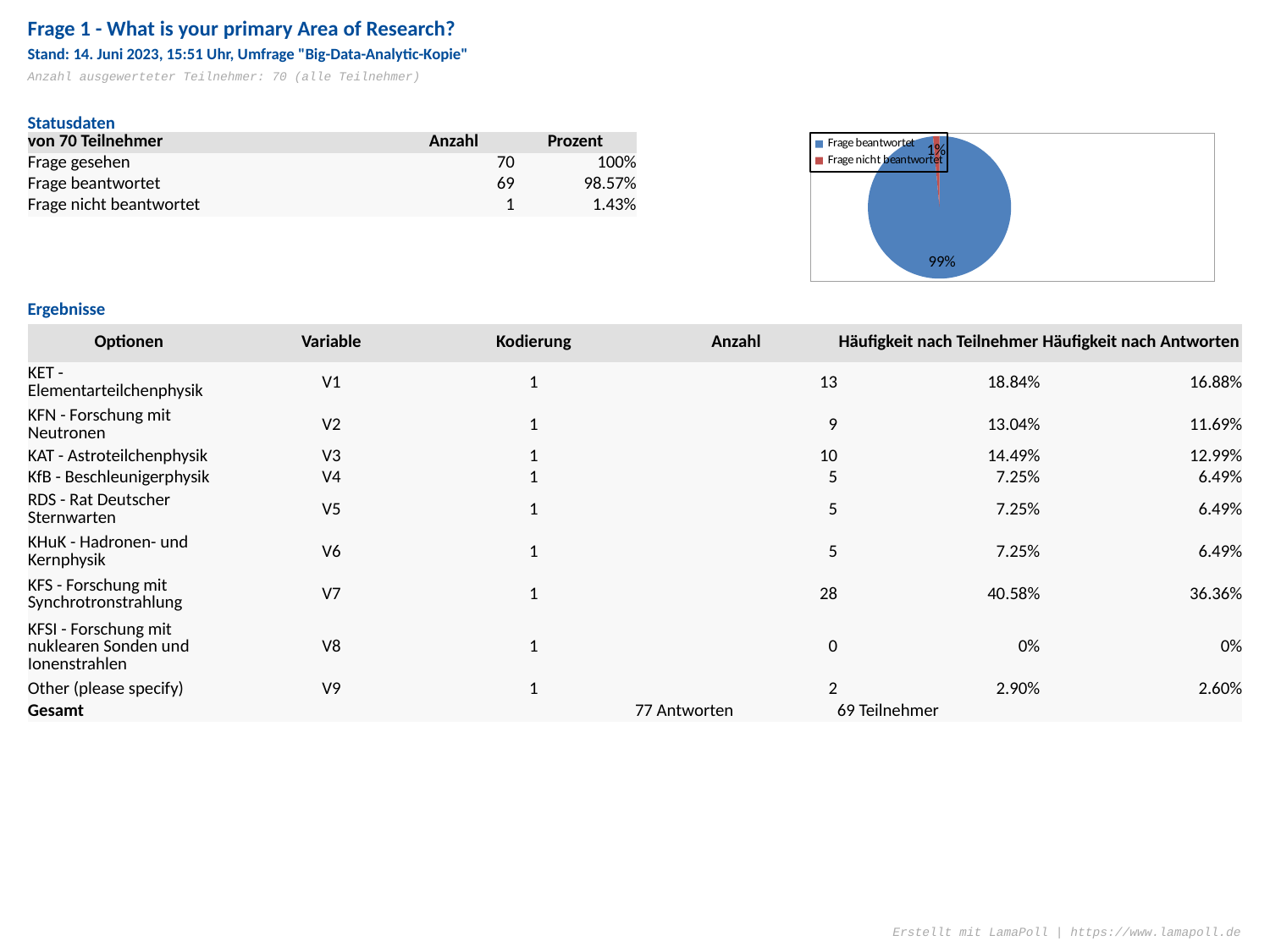
What is the difference in percentage points between the "Frage beantwortet" and "Frage nicht beantwortet" slices? 98% Which slice of the pie chart is the largest? Frage beantwortet What is the first entry listed in the pie chart's legend? Frage beantwortet Which slice of the pie chart is the smallest? Frage nicht beantwortet How many entries does the pie chart's legend list? 2 What share of the pie does "Frage beantwortet" take? 99% Which is larger in the pie chart, "Frage beantwortet" or "Frage nicht beantwortet"? Frage beantwortet How many slices does the pie chart have? 2 What share of the pie does "Frage nicht beantwortet" take? 1% What colour is the "Frage beantwortet" slice of the pie chart? blue What kind of chart is shown on the slide? pie chart